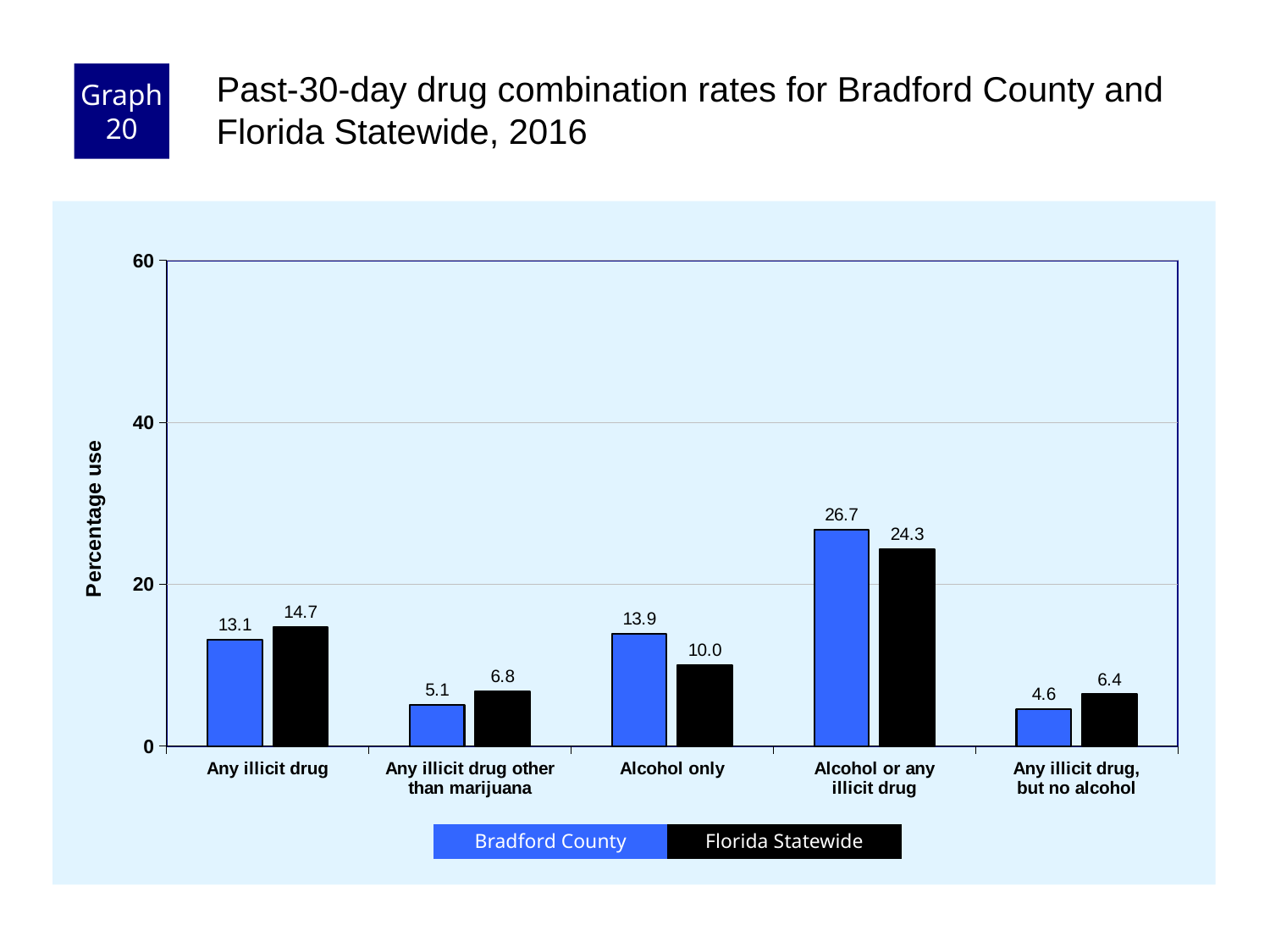
Which category has the lowest Florida Statewide value? Any illicit drug, but no alcohol What is the difference between the Bradford County and Florida Statewide values for Alcohol or any illicit drug? 2.4 What is the Bradford County value for Any illicit drug, but no alcohol? 4.6 Is the Florida Statewide value for Alcohol or any illicit drug greater or less than 20? greater Which is larger for Any illicit drug other than marijuana: Bradford County or Florida Statewide? Florida Statewide What is the Bradford County value for Any illicit drug? 13.1 What is the Florida Statewide value for Alcohol only? 10.0 Which category has the highest Bradford County value? Alcohol or any illicit drug What is the label of the y axis? Percentage use How many series does the legend list? 2 What kind of chart is shown on the slide? bar chart How many categories are shown on the x axis? 5